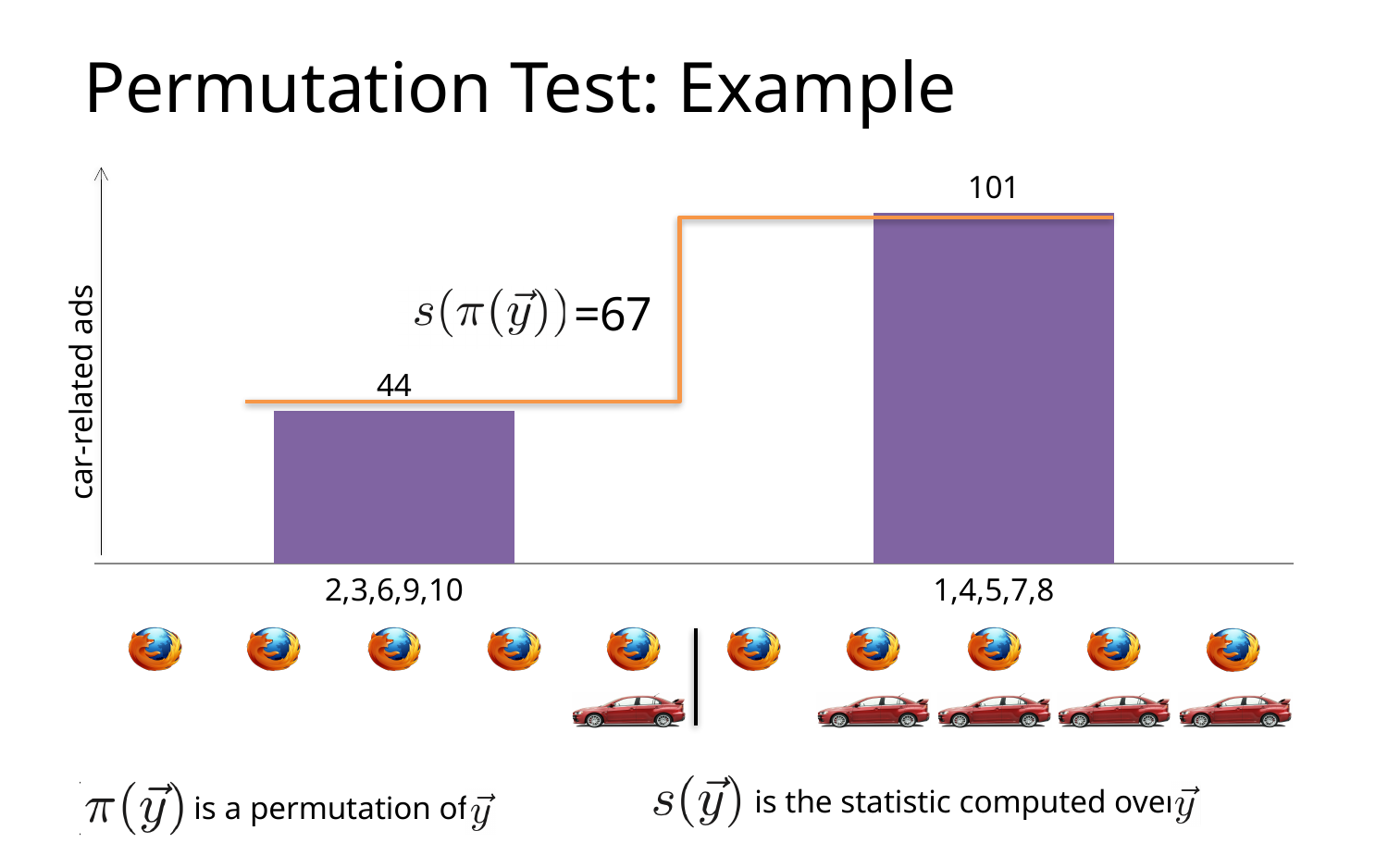
What is the difference between the values of the two bars? 57 What value of the statistic s(π(y)) is printed on the chart? 67 What is the value of the bar labelled 2,3,6,9,10? 44 Which bar is taller, 2,3,6,9,10 or 1,4,5,7,8? 1,4,5,7,8 What is the value of the bar labelled 1,4,5,7,8? 101 What kind of chart is shown on the slide? bar chart How many bars are shown in the chart? 2 What is the label on the vertical axis of the chart? car-related ads Which category has the highest bar? 1,4,5,7,8 Which category has the lowest bar? 2,3,6,9,10 What is the title of the slide containing the chart? Permutation Test: Example